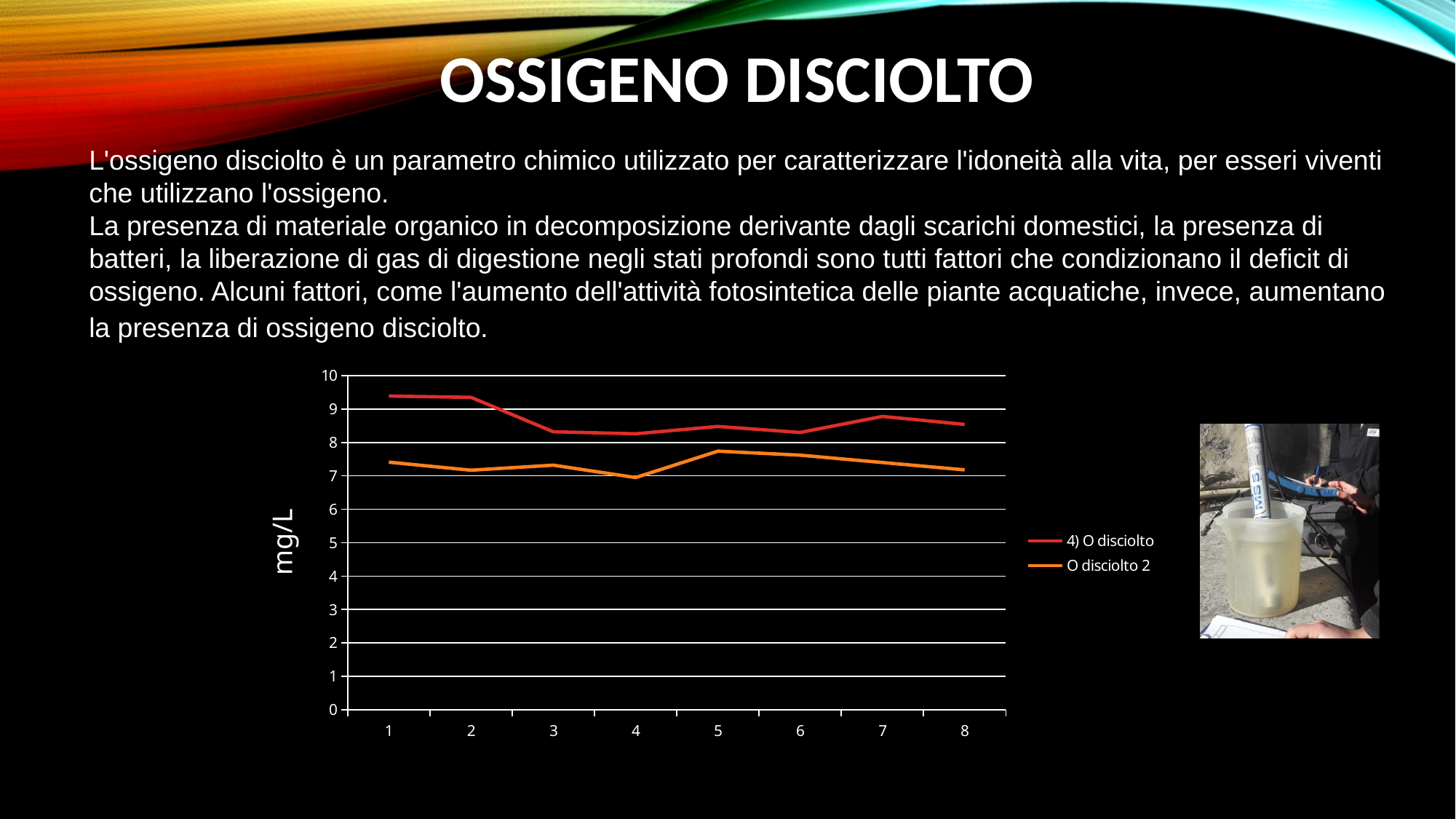
Is the value of the "4) O disciolto" series at point 3 greater or less than 9? less What is the label on the vertical axis of the chart? mg/L Which series is drawn in orange in the chart? O disciolto 2 How many points are plotted along the x axis for each series? 8 Does the "4) O disciolto" series rise or fall from point 1 to point 3? fall At point 1, which series has the larger value, "4) O disciolto" or "O disciolto 2"? 4) O disciolto Is the value of the "4) O disciolto" series at point 1 greater or less than 9? greater What kind of chart is shown on the slide? line chart How many series does the chart legend list? 2